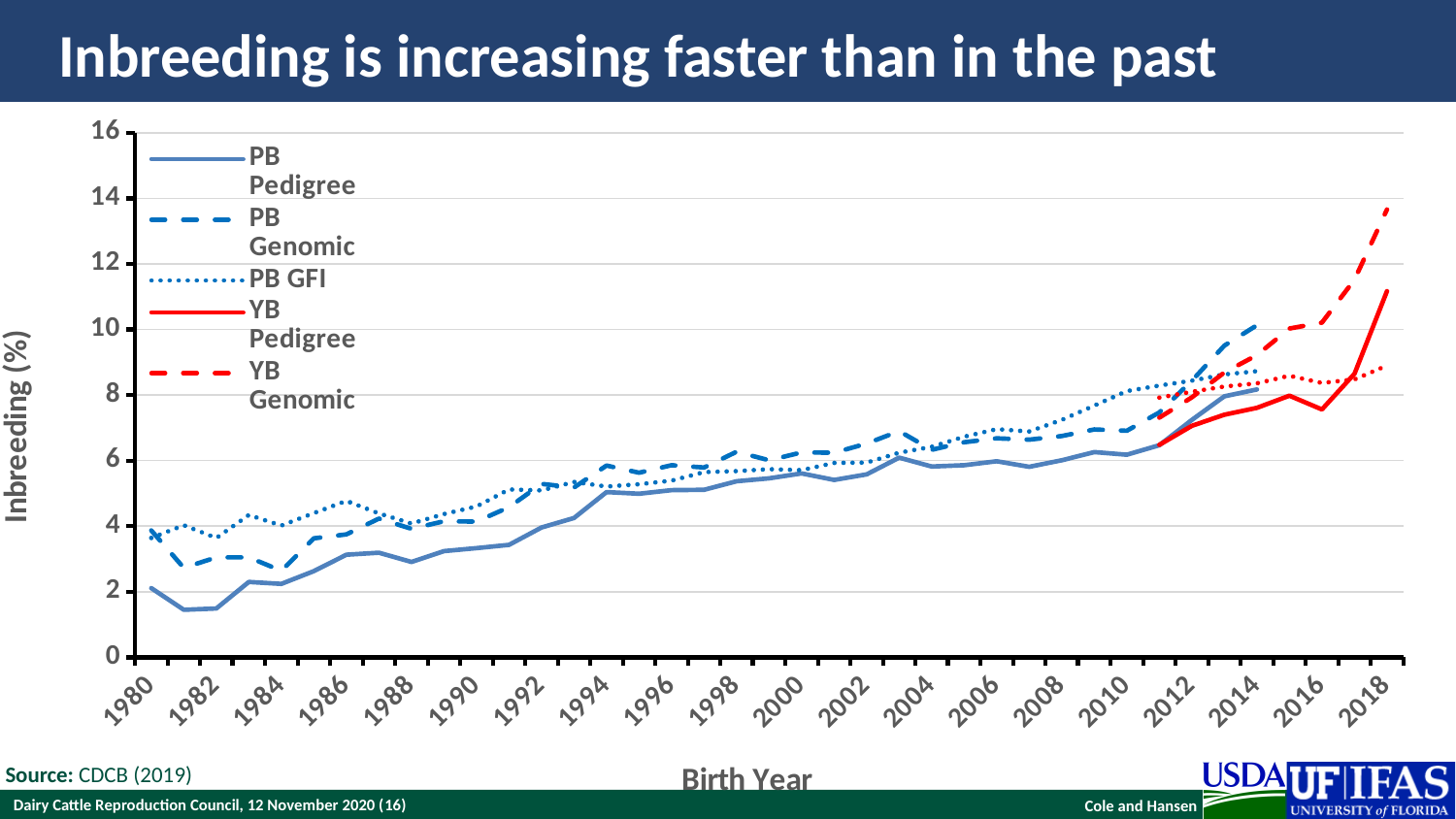
What kind of chart is shown on the slide? line chart Is the value for PB Genomic in 2014 greater or less than 8? greater In 2018, which is higher: YB Genomic or YB Pedigree? YB Genomic Is the value for PB Pedigree in 1980 greater or less than 4? less How many series does the legend list? 5 Is the value for YB Pedigree in 2016 greater or less than 10? less What is the label on the vertical axis? Inbreeding (%) Does the PB Pedigree series rise or fall from 1980 to 2018? rise In 1980, which is higher: PB GFI or PB Pedigree? PB GFI Which series reaches the highest value on the chart? YB Genomic What is the title of the chart? Inbreeding is increasing faster than in the past